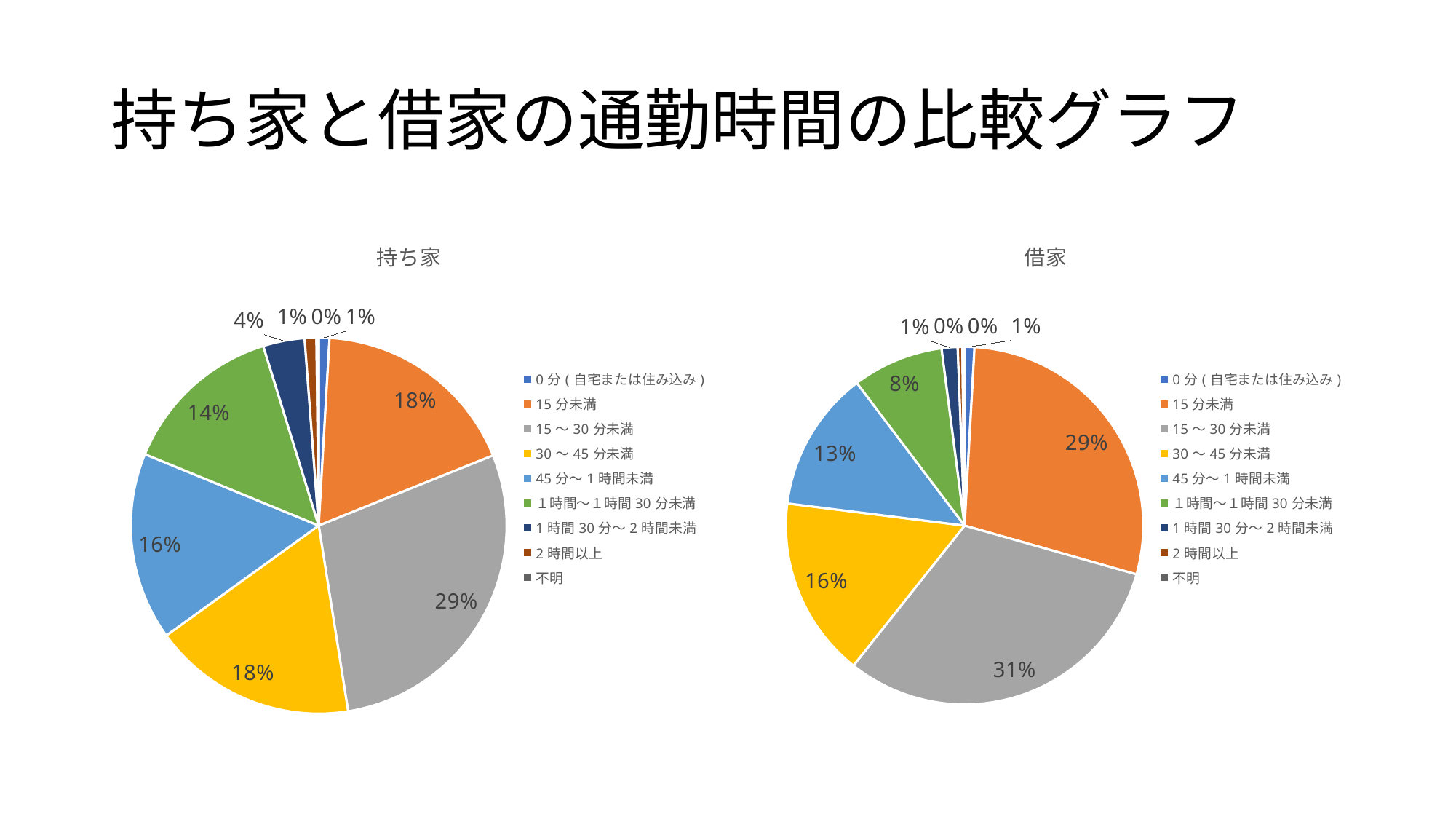
In the 持ち家 pie chart, which category has the largest share? 15 〜 30 分未満 In the 持ち家 pie chart, what share is shown for 15 〜 30 分未満? 29% In the 借家 pie chart, what share is shown for 15 分未満? 29% Which chart shows a larger share for 1 時間〜 1 時間 30 分未満, 持ち家 or 借家? 持ち家 In the 借家 pie chart, which category has the largest share? 15 〜 30 分未満 What is the title of the slide? 持ち家と借家の通勤時間の比較グラフ What kind of chart is used for 借家? Pie chart How many categories does the legend of the 持ち家 chart list? 9 In the 借家 pie chart, what share is shown for 1 時間〜 1 時間 30 分未満? 8% In the 借家 pie chart, what is the difference between the shares for 30 〜 45 分未満 and 45 分〜 1 時間未満? 3% In the 持ち家 pie chart, what is the difference between the shares for 15 〜 30 分未満 and 30 〜 45 分未満? 11% In the 持ち家 pie chart, what share is shown for 45 分〜 1 時間未満? 16%